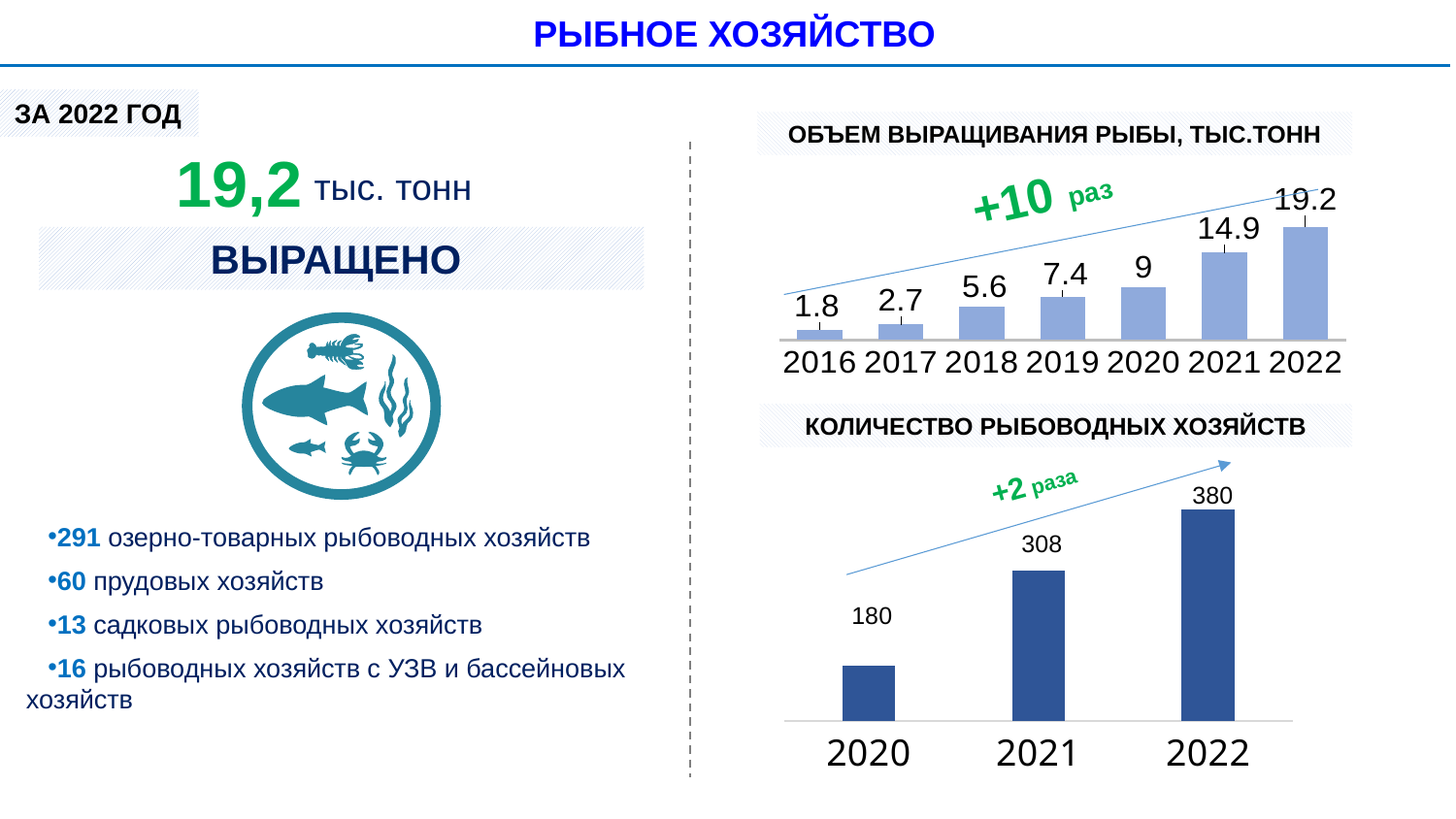
In the chart 'ОБЪЕМ ВЫРАЩИВАНИЯ РЫБЫ, ТЫС.ТОНН', which year has the lowest value? 2016 In the chart 'КОЛИЧЕСТВО РЫБОВОДНЫХ ХОЗЯЙСТВ', what is the difference between the values for 2022 and 2020? 200 In the chart 'КОЛИЧЕСТВО РЫБОВОДНЫХ ХОЗЯЙСТВ', how many years are shown? 3 In the chart 'ОБЪЕМ ВЫРАЩИВАНИЯ РЫБЫ, ТЫС.ТОНН', do the values rise or fall from 2016 to 2022? rise In the chart 'КОЛИЧЕСТВО РЫБОВОДНЫХ ХОЗЯЙСТВ', which is larger, the value for 2020 or 2021? 2021 In the chart 'ОБЪЕМ ВЫРАЩИВАНИЯ РЫБЫ, ТЫС.ТОНН', what is the value for 2016? 1.8 In the chart 'ОБЪЕМ ВЫРАЩИВАНИЯ РЫБЫ, ТЫС.ТОНН', how many years are shown? 7 In the chart 'ОБЪЕМ ВЫРАЩИВАНИЯ РЫБЫ, ТЫС.ТОНН', what is the difference between the values for 2022 and 2021? 4.3 In the chart 'ОБЪЕМ ВЫРАЩИВАНИЯ РЫБЫ, ТЫС.ТОНН', which year has the highest value? 2022 In the chart 'КОЛИЧЕСТВО РЫБОВОДНЫХ ХОЗЯЙСТВ', what is the value for 2021? 308 In the chart 'ОБЪЕМ ВЫРАЩИВАНИЯ РЫБЫ, ТЫС.ТОНН', what is the value for 2019? 7.4 What type of chart is 'КОЛИЧЕСТВО РЫБОВОДНЫХ ХОЗЯЙСТВ'? bar chart